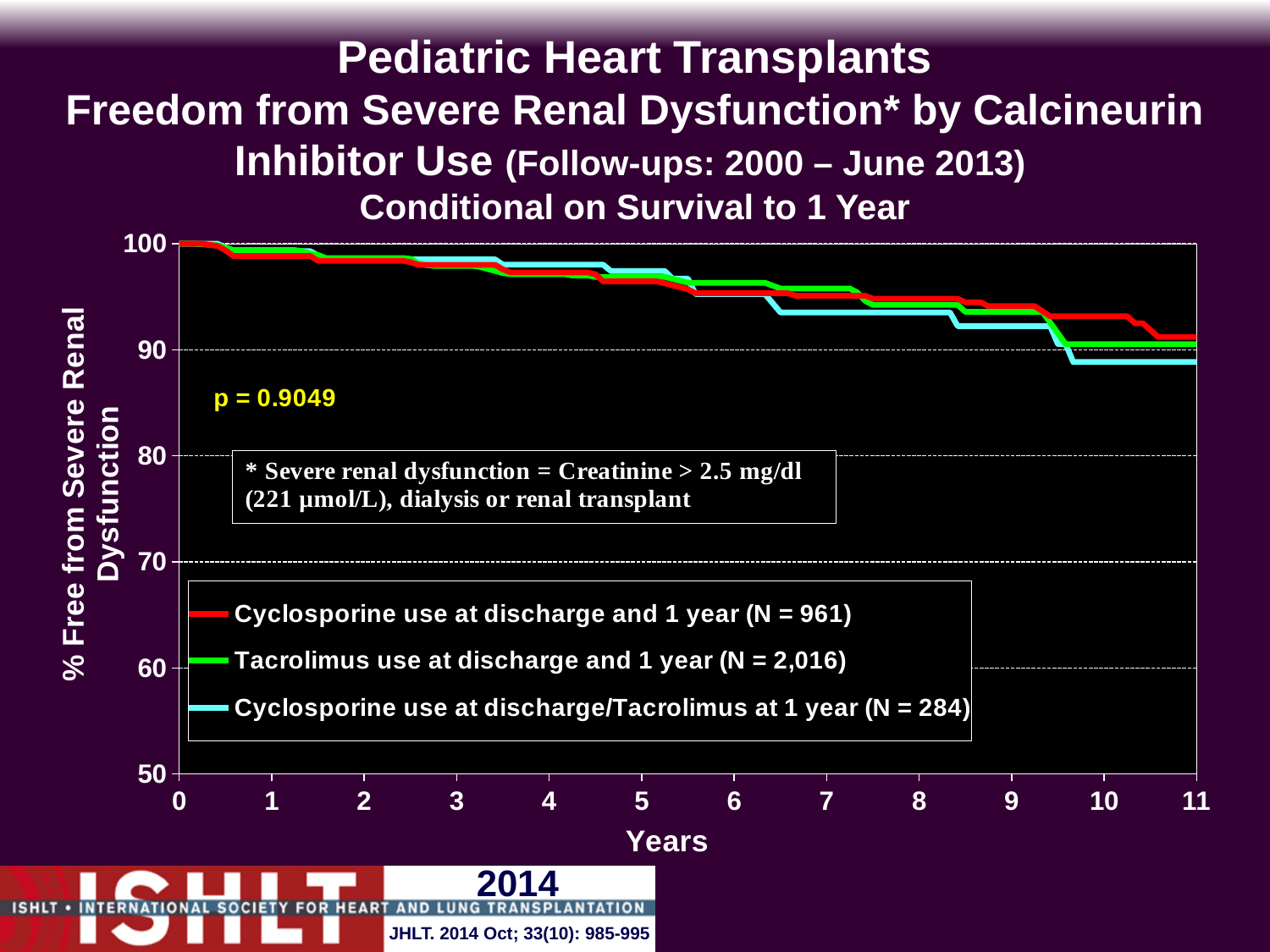
Is the value for the Cyclosporine use at discharge/Tacrolimus at 1 year series at year 11 greater or less than 80? greater What p-value is printed on the chart? p = 0.9049 Is the value for the Cyclosporine use at discharge/Tacrolimus at 1 year series at year 11 greater or less than 100? less Which series has the lowest value at year 11? Cyclosporine use at discharge/Tacrolimus at 1 year How many series does the legend list? 3 What is the N for the Tacrolimus use at discharge and 1 year series in the legend? 2,016 At year 10, which series has the higher value: Cyclosporine use at discharge and 1 year, or Cyclosporine use at discharge/Tacrolimus at 1 year? Cyclosporine use at discharge and 1 year Which series has the highest value at year 10? Cyclosporine use at discharge and 1 year What kind of chart is shown on the slide? line chart Do the plotted values rise or fall as the years increase along the x axis? fall Is the value for the Tacrolimus use at discharge and 1 year series at year 5 greater or less than 90? greater